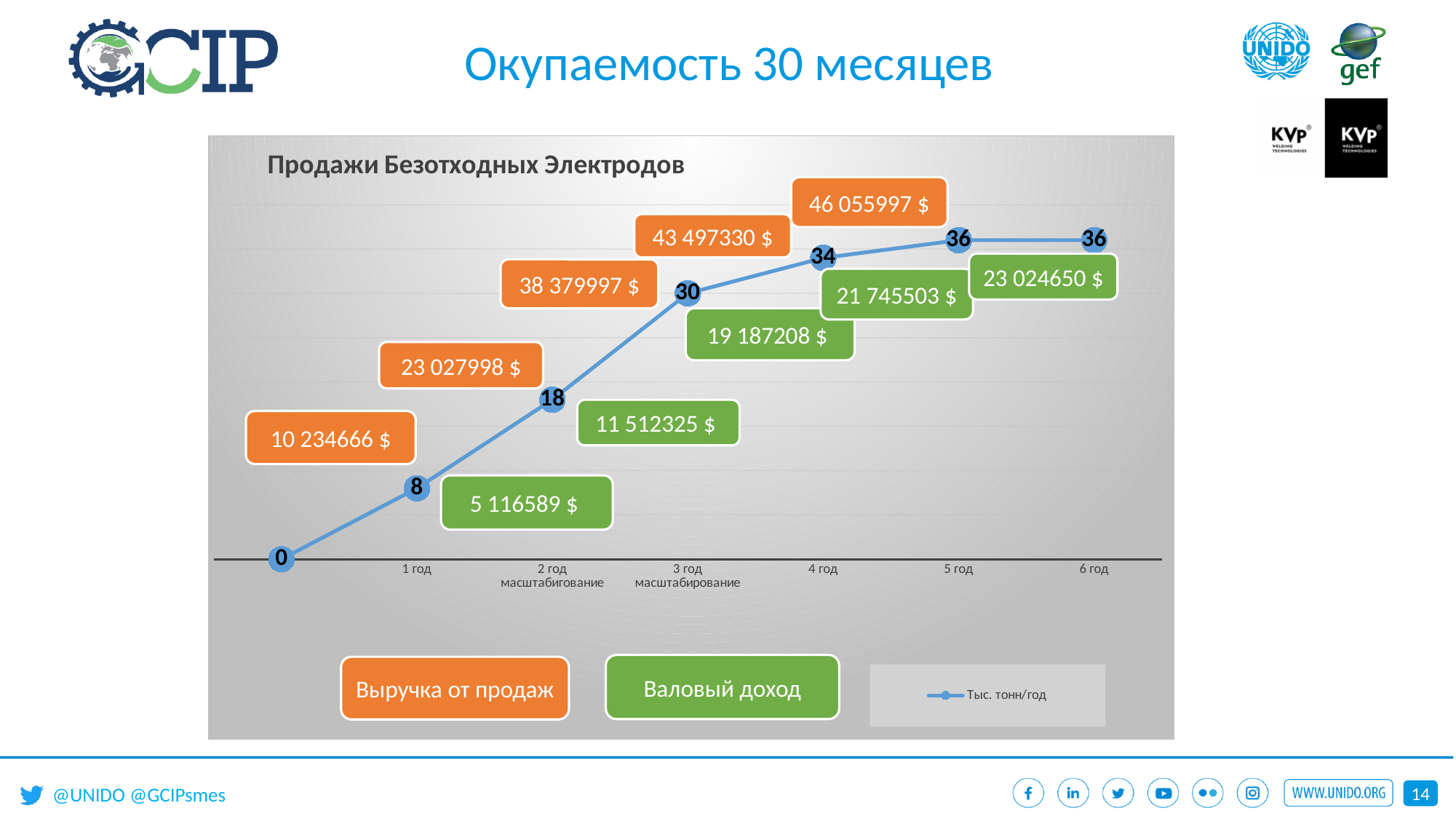
What is the largest value shown in the orange 'Выручка от продаж' boxes? 46 055997 $ What is the value of the line at 6 год? 36 What is the value of the line at 4 год? 34 What is the value of the line at 1 год? 8 What is the value of the line at 3 год масштабирование? 30 How many series does the chart legend list? 1 What series does the chart legend list? Тыс. тонн/год What type of chart is shown on the slide? line chart What is the title of the chart? Продажи Безотходных Электродов Which is larger, the line value at 2 год масштабигование or at 4 год? 4 год Does the line rise or fall from the first point to 5 год? rise What is the difference between the line values at 3 год масштабирование and 2 год масштабигование? 12